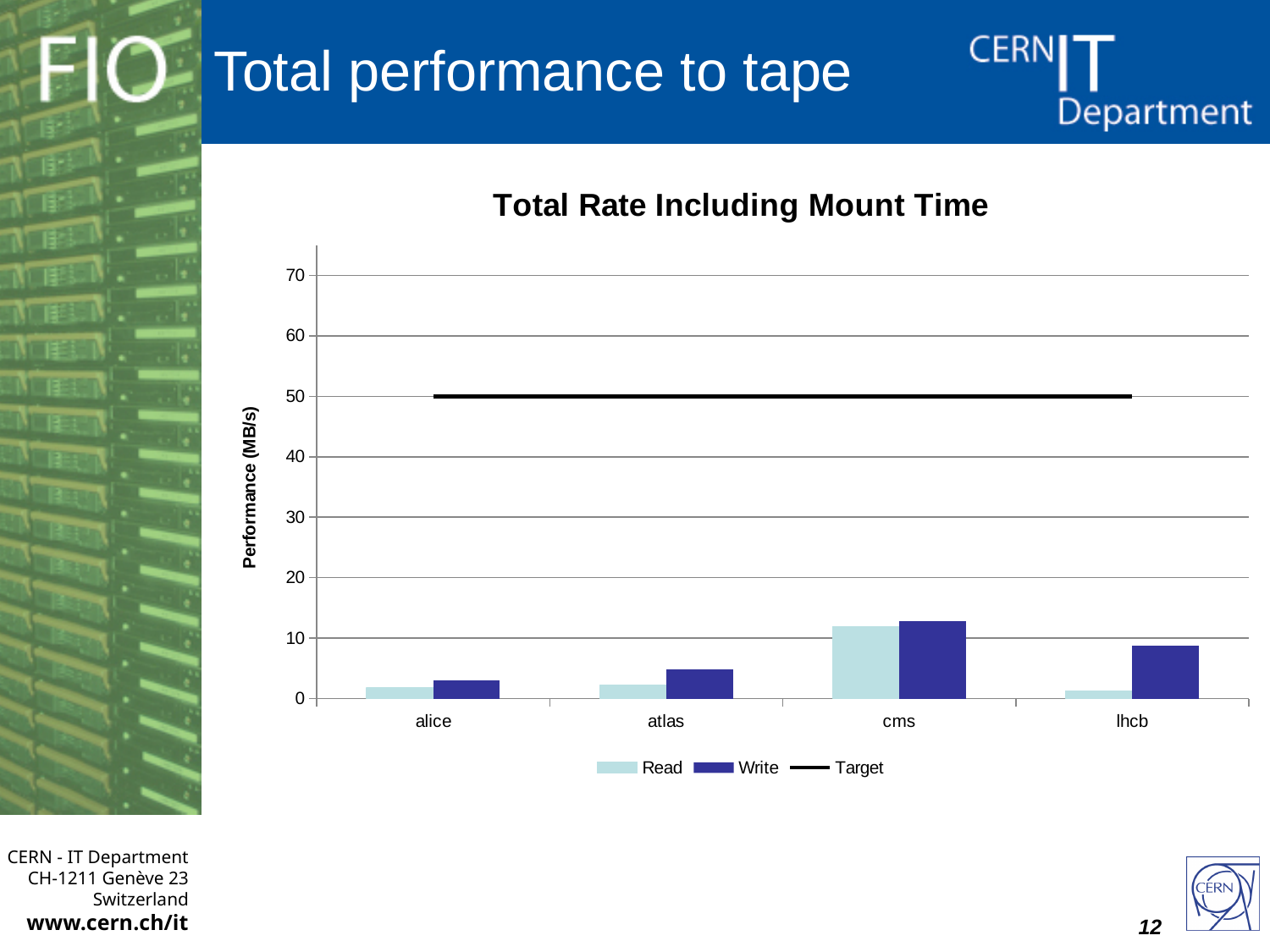
What value does the Target line sit at on the y axis? 50 Which category has the highest Read value? cms Which category has the highest Write value? cms Is the Write value for lhcb greater or less than 5? greater How many categories are shown on the x axis of the chart? 4 Is the Write value for cms greater or less than 10? greater How many series does the chart legend list? 3 What is the label of the y axis? Performance (MB/s) Which category has the lowest Write value? alice What kind of chart is shown on the slide? bar chart For lhcb, which is larger, the Read value or the Write value? Write Is the Write value for alice greater or less than 10? less